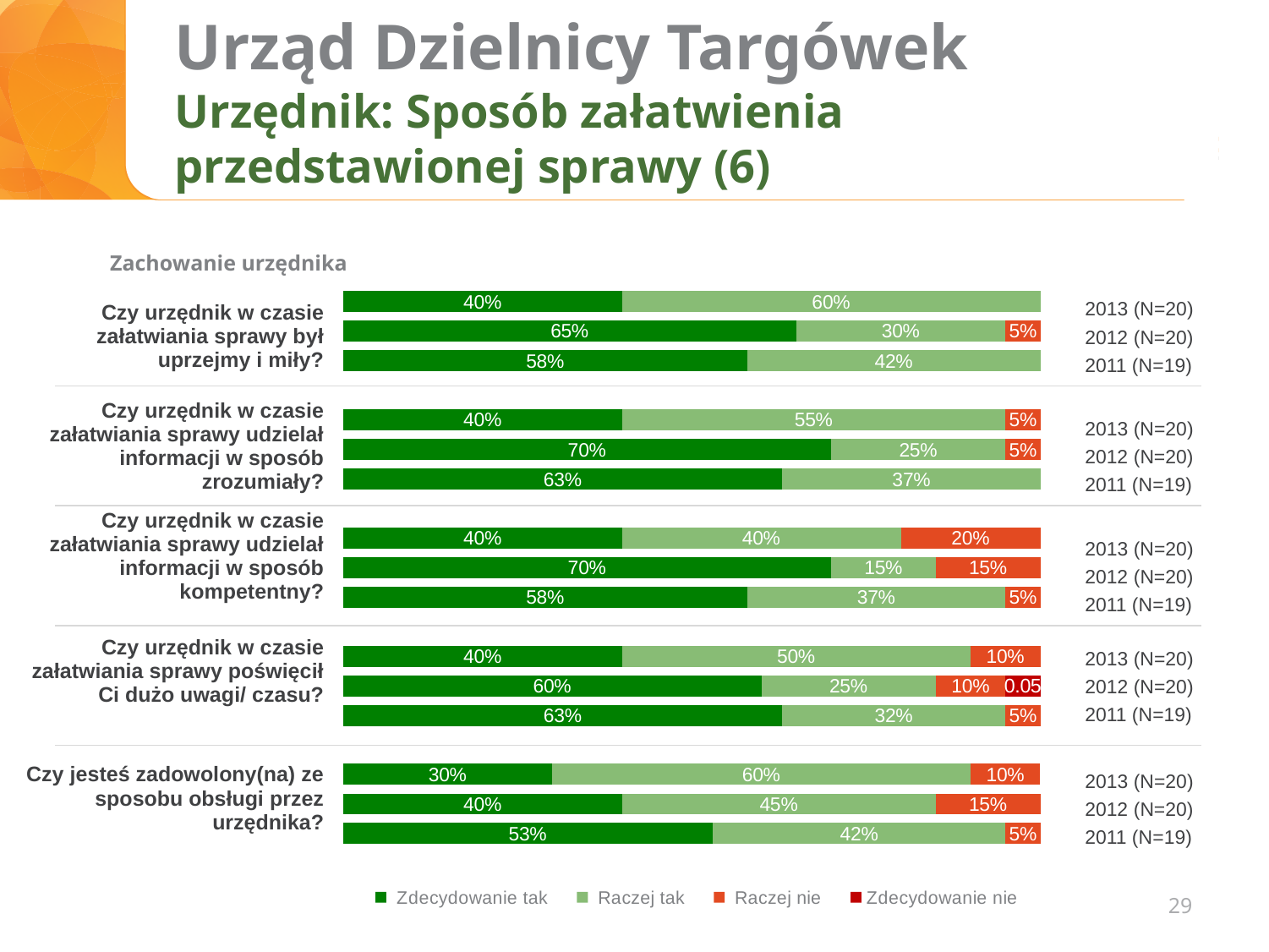
In the chart for "Czy urzędnik w czasie załatwiania sprawy udzielał informacji w sposób zrozumiały?", how many percentage points higher is the "Zdecydowanie tak" value for 2012 than for 2013? 30 percentage points In the chart for "Czy urzędnik w czasie załatwiania sprawy był uprzejmy i miły?", what is the "Zdecydowanie tak" value for 2012 (N=20)? 65% In the chart for "Czy urzędnik w czasie załatwiania sprawy poświęcił Ci dużo uwagi/ czasu?", what is the "Zdecydowanie nie" value for 2012 (N=20)? 0.05 In the chart for "Czy jesteś zadowolony(na) ze sposobu obsługi przez urzędnika?", what is the "Raczej tak" value for 2013 (N=20)? 60% How many series does the legend at the bottom of the slide list? 4 How many bars (years) are shown in the chart for "Czy urzędnik w czasie załatwiania sprawy był uprzejmy i miły?"? 3 In the chart for "Czy jesteś zadowolony(na) ze sposobu obsługi przez urzędnika?", which year has the lowest "Zdecydowanie tak" share? 2013 (N=20) What kind of chart is used on this slide? Stacked bar chart In the chart for "Czy urzędnik w czasie załatwiania sprawy udzielał informacji w sposób kompetentny?", which year has the highest "Zdecydowanie tak" share? 2012 (N=20) In the chart for "Czy urzędnik w czasie załatwiania sprawy był uprzejmy i miły?", what is the total of the 2013 (N=20) bar? 100% In the chart for "Czy urzędnik w czasie załatwiania sprawy poświęcił Ci dużo uwagi/ czasu?", which year has the larger "Zdecydowanie tak" value, 2011 or 2012? 2011 (N=19) In the chart for "Czy urzędnik w czasie załatwiania sprawy udzielał informacji w sposób kompetentny?", what is the "Raczej nie" value for 2013 (N=20)? 20%